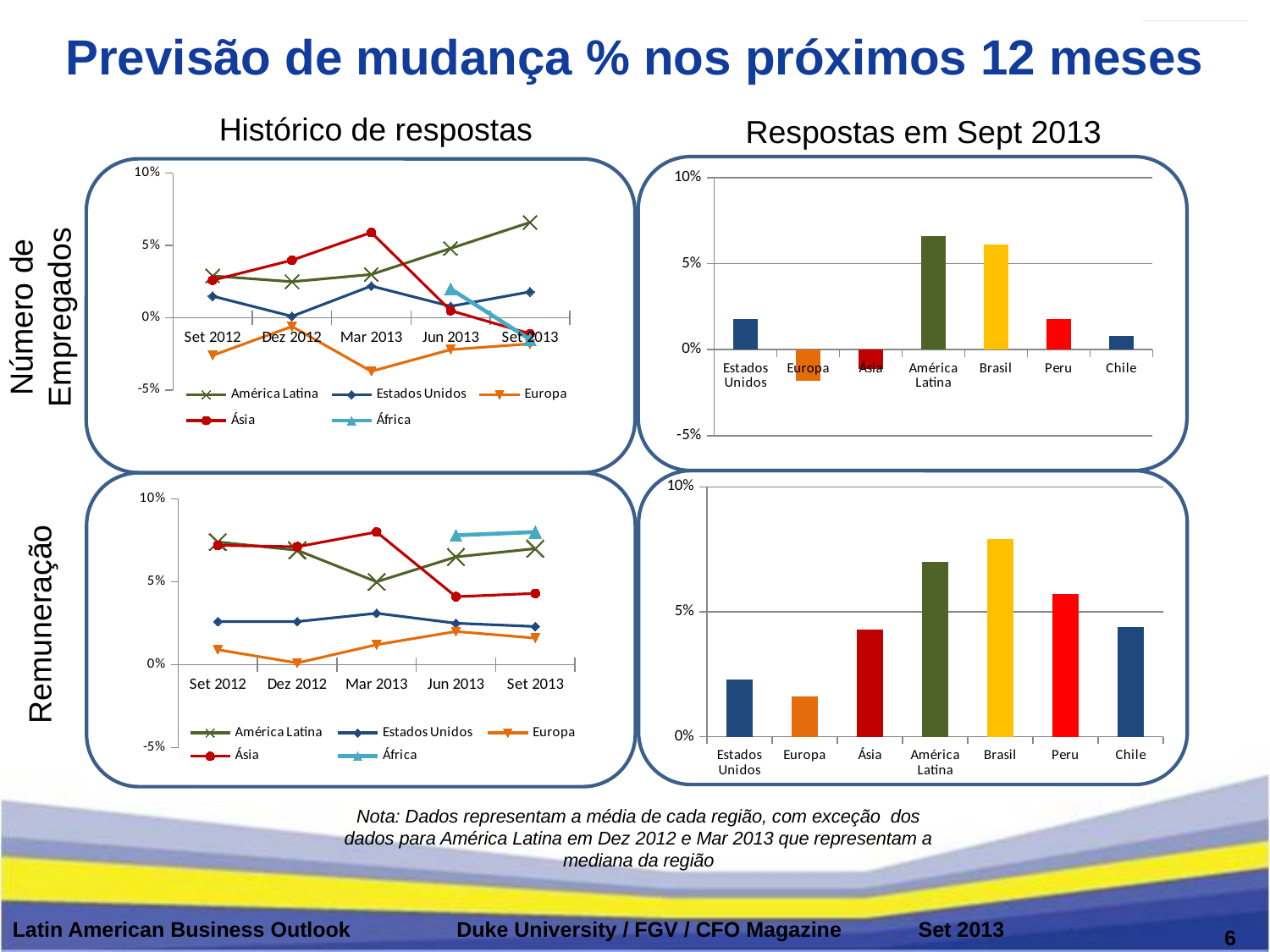
In the top-left line chart (Número de Empregados, Histórico de respostas), does the América Latina series rise or fall from Dez 2012 to Set 2013? rise How many series does the legend of the top-left line chart (Número de Empregados, Histórico de respostas) list? 5 In the bottom-right bar chart (Remuneração, Respostas em Sept 2013), is the value for Chile greater or less than 5%? less In the bottom-right bar chart (Remuneração, Respostas em Sept 2013), which is larger, the value for Peru or the value for Estados Unidos? Peru In the bottom-right bar chart (Remuneração, Respostas em Sept 2013), which category has the lowest value? Europa In the bottom-right bar chart (Remuneração, Respostas em Sept 2013), which category has the highest value? Brasil In the top-right bar chart (Número de Empregados, Respostas em Sept 2013), how many categories are shown on the x axis? 7 In the top-right bar chart (Número de Empregados, Respostas em Sept 2013), is the value for Estados Unidos greater or less than 5%? less In the top-right bar chart (Número de Empregados, Respostas em Sept 2013), is the value for América Latina greater or less than 5%? greater In the top-right bar chart (Número de Empregados, Respostas em Sept 2013), which category has the lowest value? Europa What kind of chart is the bottom-left chart (Remuneração, Histórico de respostas)? line chart